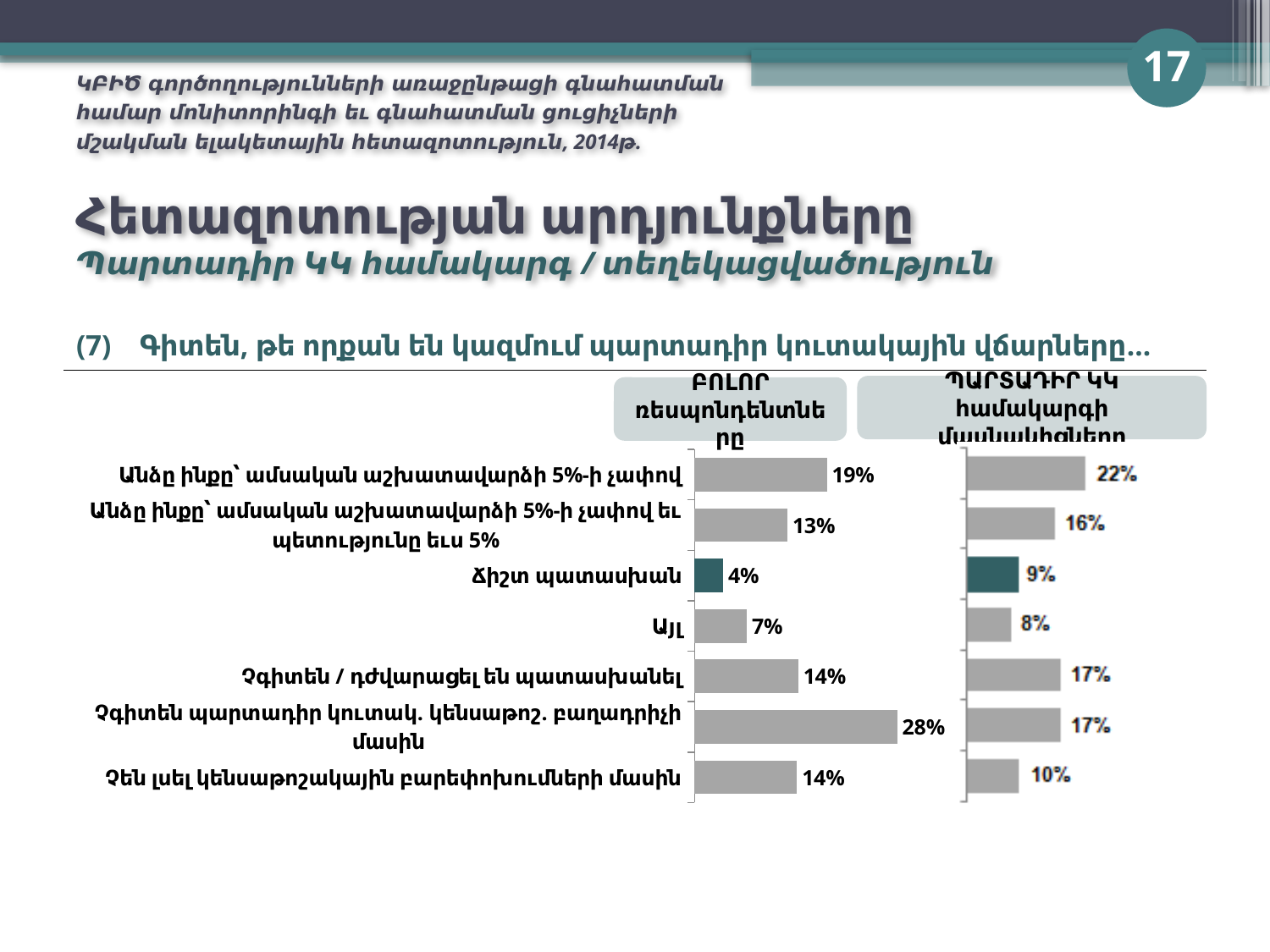
In the left chart (ԲՈԼՈՐ ռեսպոնդենտները), what is the value for "Չգիտեն պարտադիր կուտակ. կենսաթոշ. բաղադրիչի մասին"? 28% In the left chart (ԲՈԼՈՐ ռեսպոնդենտները), which category has the highest value? Չգիտեն պարտադիր կուտակ. կենսաթոշ. բաղադրիչի մասին In the left chart (ԲՈԼՈՐ ռեսպոնդենտները), which is larger: the value for "Անձը ինքը՝ ամսական աշխատավարձի 5%-ի չափով" or for "Այլ"? Անձը ինքը՝ ամսական աշխատավարձի 5%-ի չափով What is the difference between the "Ճիշտ պատասխան" value in the right chart (9%) and in the left chart (4%)? 5 percentage points In the left chart (ԲՈԼՈՐ ռեսպոնդենտները), which category has the lowest value? Ճիշտ պատասխան In the right chart (ՊԱՐՏԱԴԻՐ ԿԿ համակարգի մասնակիցները), which category has the highest value? Անձը ինքը՝ ամսական աշխատավարձի 5%-ի չափով In the right chart (ՊԱՐՏԱԴԻՐ ԿԿ համակարգի մասնակիցները), what is the value for "Չեն լսել կենսաթոշակային բարեփոխումների մասին"? 10% How many categories are shown in the left chart (ԲՈԼՈՐ ռեսպոնդենտները)? 7 In the left chart (ԲՈԼՈՐ ռեսպոնդենտները), what is the value for "Ճիշտ պատասխան"? 4% In the right chart (ՊԱՐՏԱԴԻՐ ԿԿ համակարգի մասնակիցները), what is the value for "Ճիշտ պատասխան"? 9% What type of chart is used on this slide? Bar chart In the right chart (ՊԱՐՏԱԴԻՐ ԿԿ համակարգի մասնակիցները), which category has the lowest value? Այլ